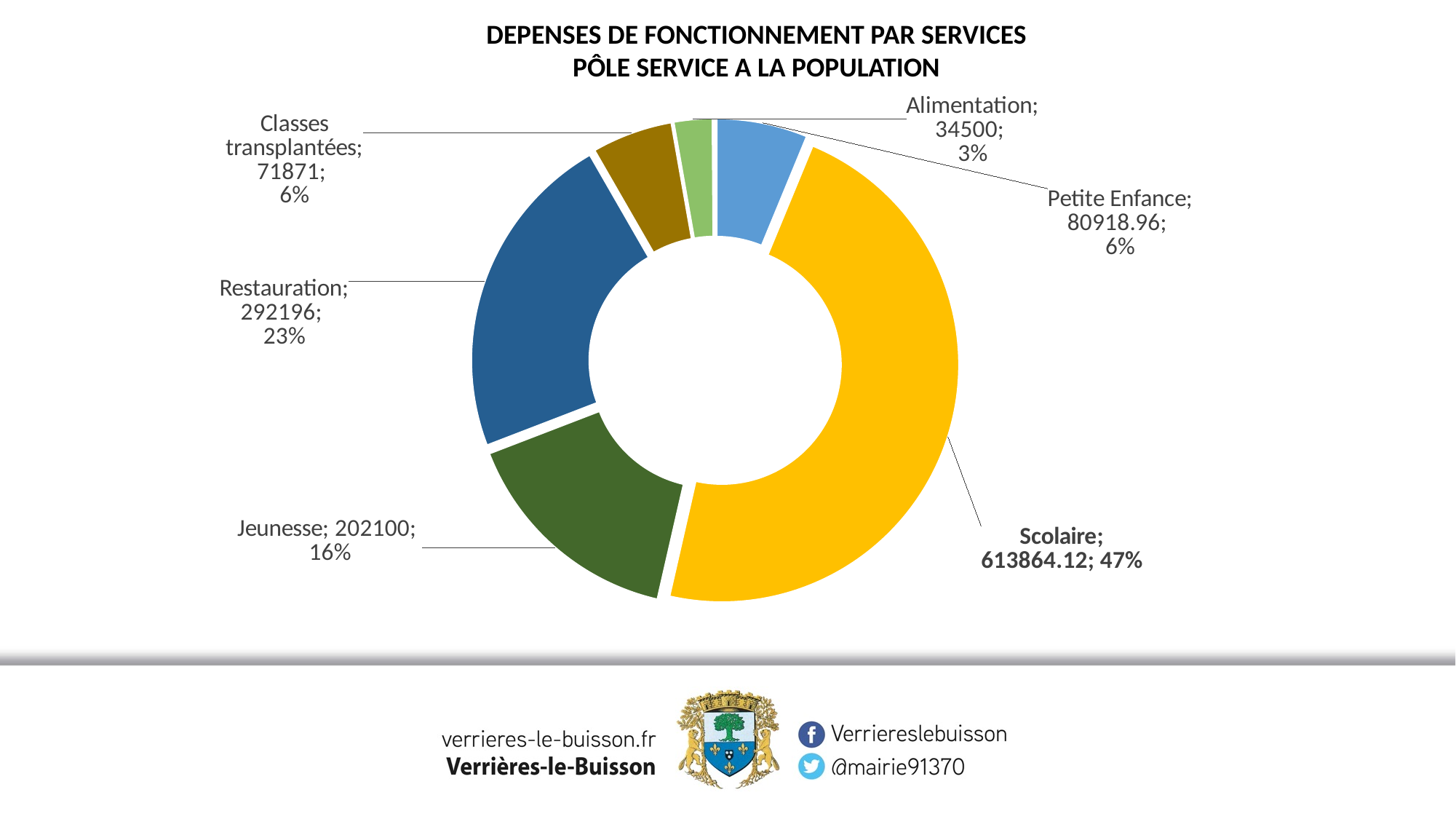
Which category has the largest share of the chart? Scolaire Which labelled category has the smallest value? Alimentation What is the difference between the values for Restauration and Jeunesse? 90096 What percentage share is shown for Alimentation? 3% What is the value shown for Restauration? 292196 What is the title of the chart? DEPENSES DE FONCTIONNEMENT PAR SERVICES PÔLE SERVICE A LA POPULATION What is the value shown for Petite Enfance? 80918.96 What is the value shown for Scolaire? 613864.12 Which is larger, the value for Petite Enfance or the value for Classes transplantées? Petite Enfance What kind of chart is shown on the slide? doughnut chart What percentage share is shown for Jeunesse? 16% What is the difference between the values for Scolaire and Restauration? 321668.12